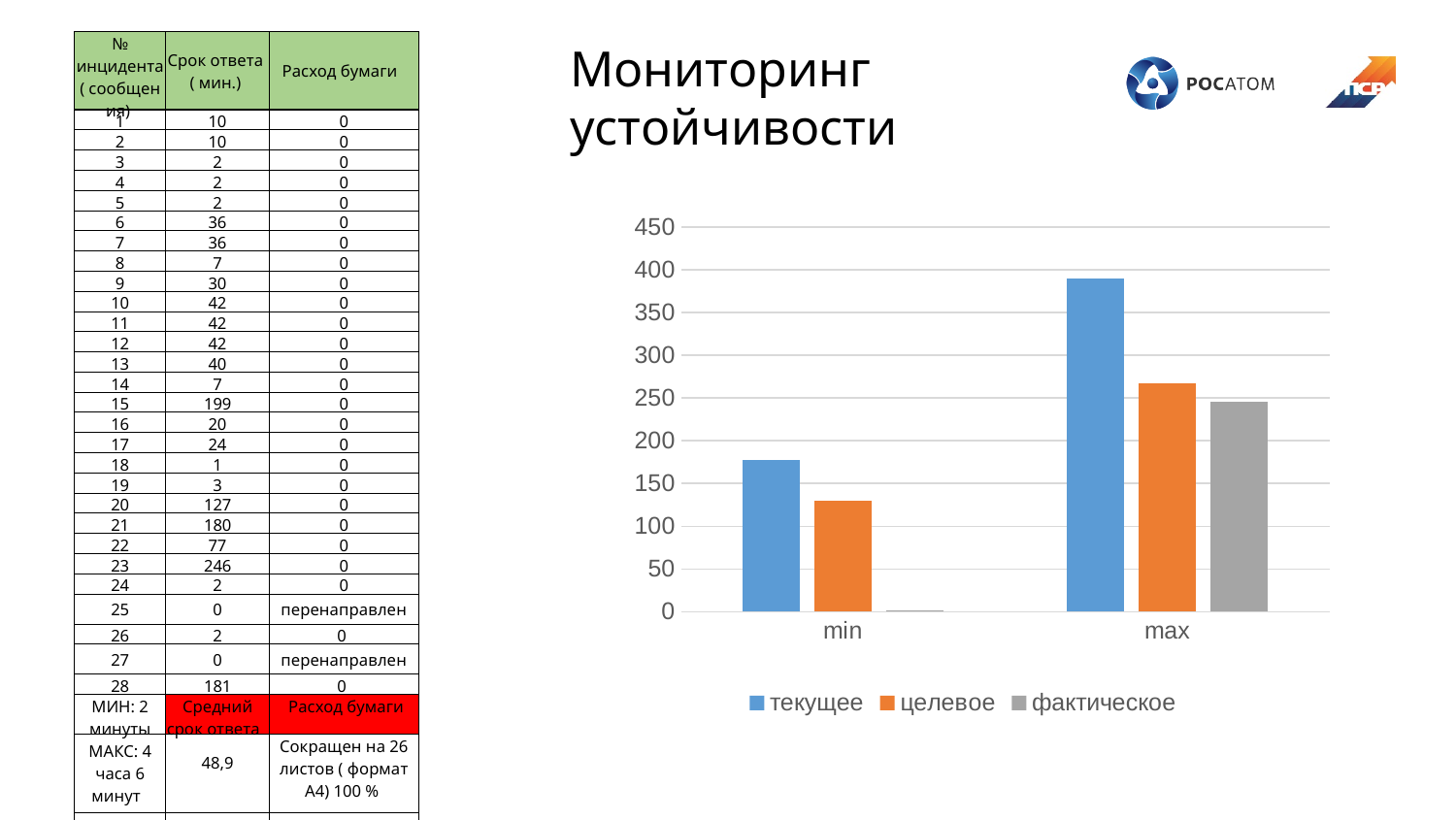
What kind of chart is shown on the slide? bar chart Is the value of 'целевое' for 'min' greater or less than 150? less What are the names of the series listed in the chart legend? текущее, целевое, фактическое Is the value of 'текущее' for 'min' greater or less than 150? greater How many series does the chart legend list? 3 Is the value of 'фактическое' for 'min' greater or less than 50? less How many categories are shown on the x axis of the chart? 2 Which colour represents the series 'целевое' in the chart? orange In the 'max' category, which is larger: 'текущее' or 'целевое'? текущее Which series has the lowest value in the 'min' category? фактическое